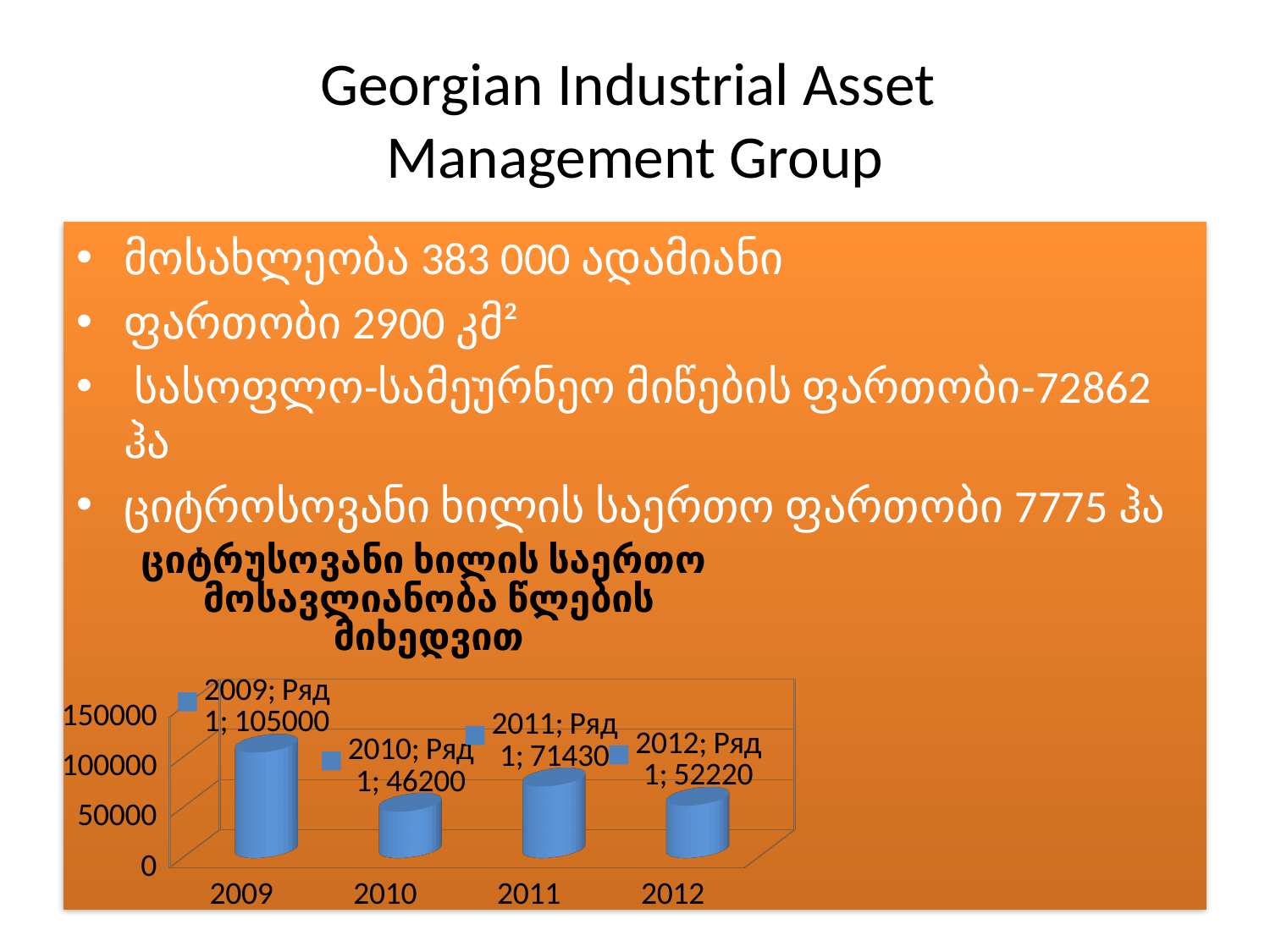
What is the difference between the values for 2009 and 2010? 58800 What kind of chart is shown on the slide? bar chart Which year has the highest value in the chart? 2009 Is the value for 2009 greater or less than 100000? greater How many years are shown on the x axis of the chart? 4 What is the difference between the values for 2011 and 2012? 19210 Which is larger, the value for 2011 or the value for 2012? 2011 Which year has the lowest value in the chart? 2010 What is the value for 2009 in the chart? 105000 What is the value for 2011 in the chart? 71430 What is the value for 2012 in the chart? 52220 What is the value for 2010 in the chart? 46200